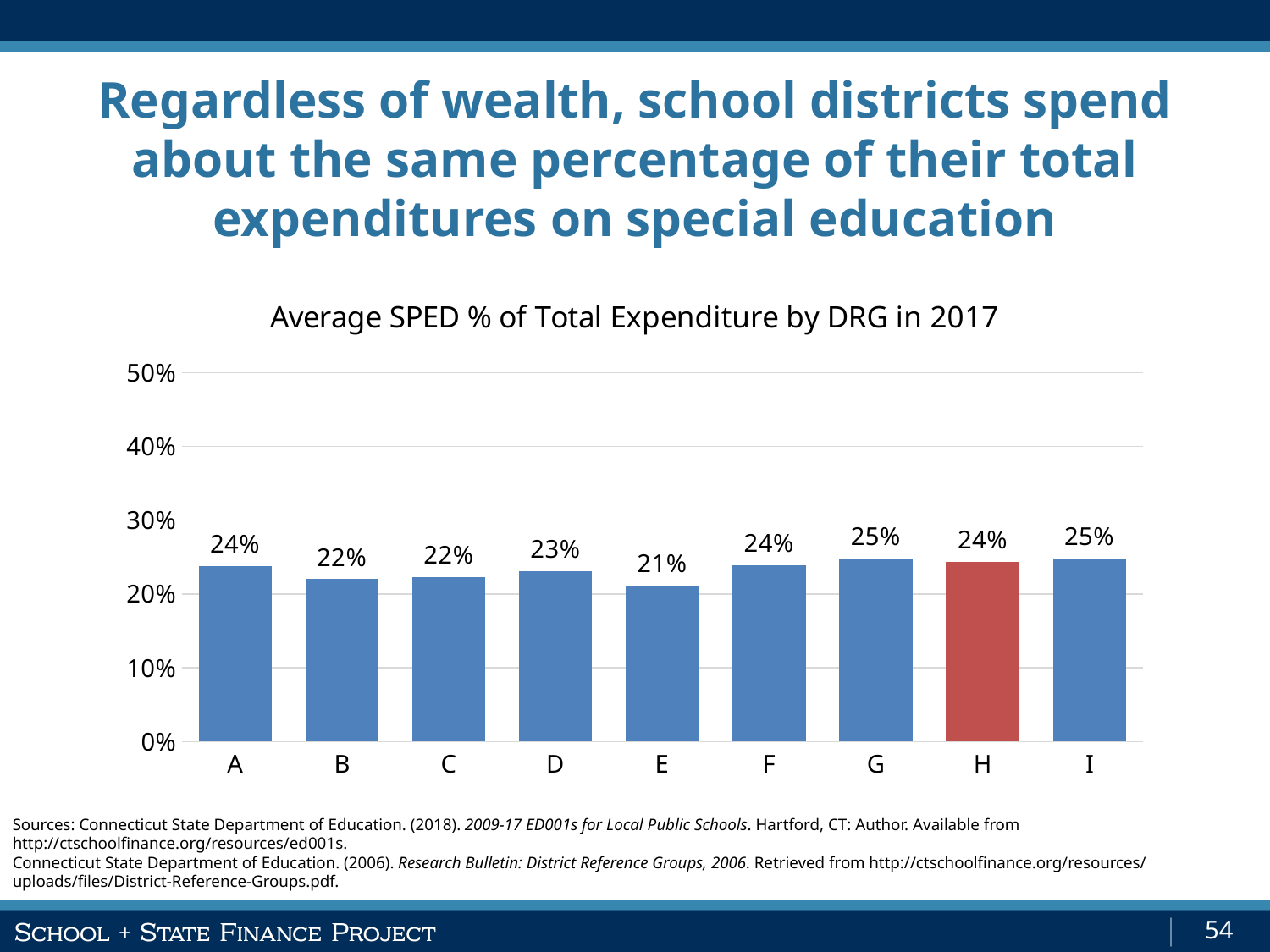
What is the title of the chart? Average SPED % of Total Expenditure by DRG in 2017 How many DRG categories are shown on the x axis? 9 What is the value for DRG E? 21% What is the value for DRG H? 24% What is the difference between the values for DRG G and DRG E? 4% Which is larger, the value for DRG F or the value for DRG B? F Is the value for DRG I greater or less than 30%? less Which DRG's bar is coloured red instead of blue? H What is the value for DRG A? 24% What is the value for DRG D? 23% What kind of chart is shown on the slide? bar chart Which DRG has the lowest average SPED % of total expenditure? E